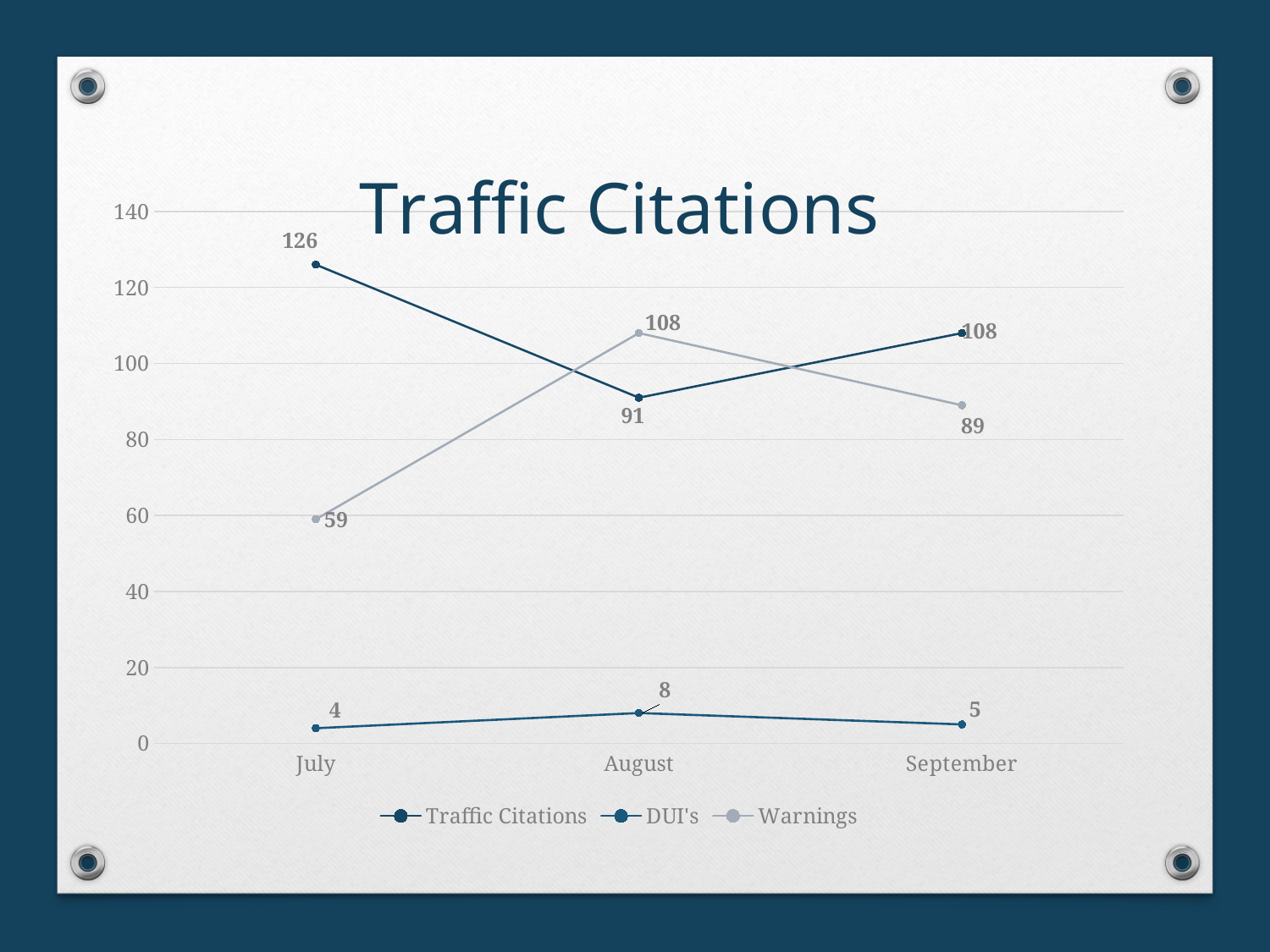
What kind of chart is shown on the slide? line chart Which is larger in September: Traffic Citations or Warnings? Traffic Citations In which month is the Warnings value highest? August How many series does the legend list? 3 What is the value for DUI's in September? 5 What is the title of the chart? Traffic Citations Is the value for Warnings in July greater or less than 80? less In which month is the Traffic Citations value lowest? August What is the value for Traffic Citations in July? 126 What is the value for Warnings in August? 108 What is the difference between Traffic Citations in July and in August? 35 How many months are shown on the x axis? 3